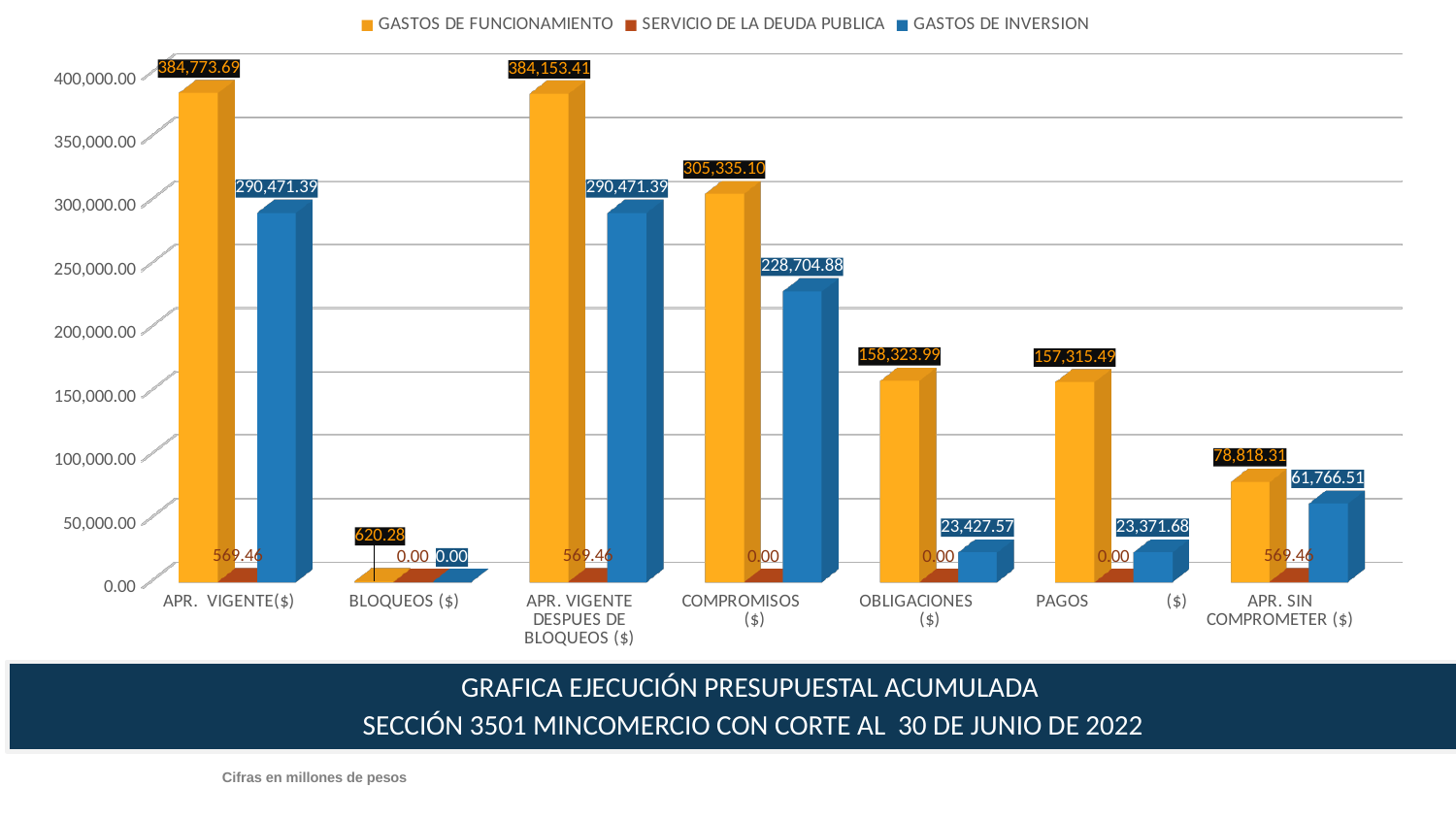
How many series does the legend list? 3 What is the value of GASTOS DE INVERSION for OBLIGACIONES ($)? 23,427.57 How many categories are shown on the x axis of the chart? 7 Which category has the lowest value for GASTOS DE INVERSION? BLOQUEOS ($) What is the value of GASTOS DE FUNCIONAMIENTO for COMPROMISOS ($)? 305,335.10 Which category has the highest value for GASTOS DE FUNCIONAMIENTO? APR. VIGENTE($) What is the value of GASTOS DE FUNCIONAMIENTO for BLOQUEOS ($)? 620.28 For APR. SIN COMPROMETER ($), which is larger: GASTOS DE FUNCIONAMIENTO or GASTOS DE INVERSION? GASTOS DE FUNCIONAMIENTO What is the difference between GASTOS DE FUNCIONAMIENTO for APR. VIGENTE($) and for APR. VIGENTE DESPUES DE BLOQUEOS ($)? 620.28 Is the value of GASTOS DE FUNCIONAMIENTO for PAGOS ($) greater or less than 150,000.00? greater What is the value of SERVICIO DE LA DEUDA PUBLICA for APR. SIN COMPROMETER ($)? 569.46 For COMPROMISOS ($), what is the difference between GASTOS DE FUNCIONAMIENTO and GASTOS DE INVERSION? 76,630.22